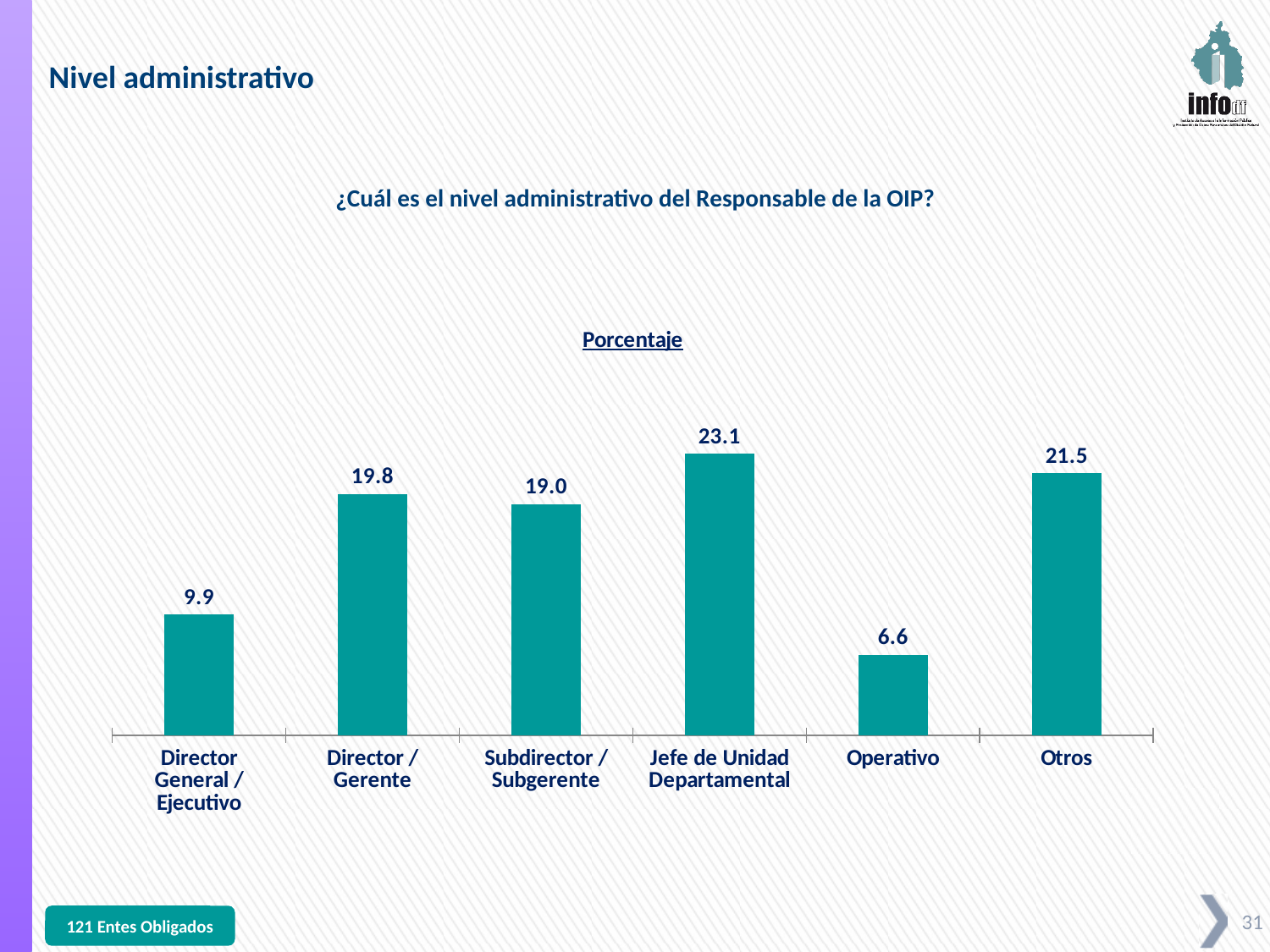
What is the value for Operativo? 6.6 What is the difference between the values for Director / Gerente and Subdirector / Subgerente? 0.8 What is the value for Jefe de Unidad Departamental? 23.1 Which category has the highest value? Jefe de Unidad Departamental What is the value for Director General / Ejecutivo? 9.9 What kind of chart is shown on the slide? Bar chart Which is larger, the value for Otros or the value for Director / Gerente? Otros What is the difference between the values for Otros and Director General / Ejecutivo? 11.6 Which category has the lowest value? Operativo What colour are the bars in the chart? Teal How many categories are shown on the x axis? 6 What is the title of the chart? Porcentaje